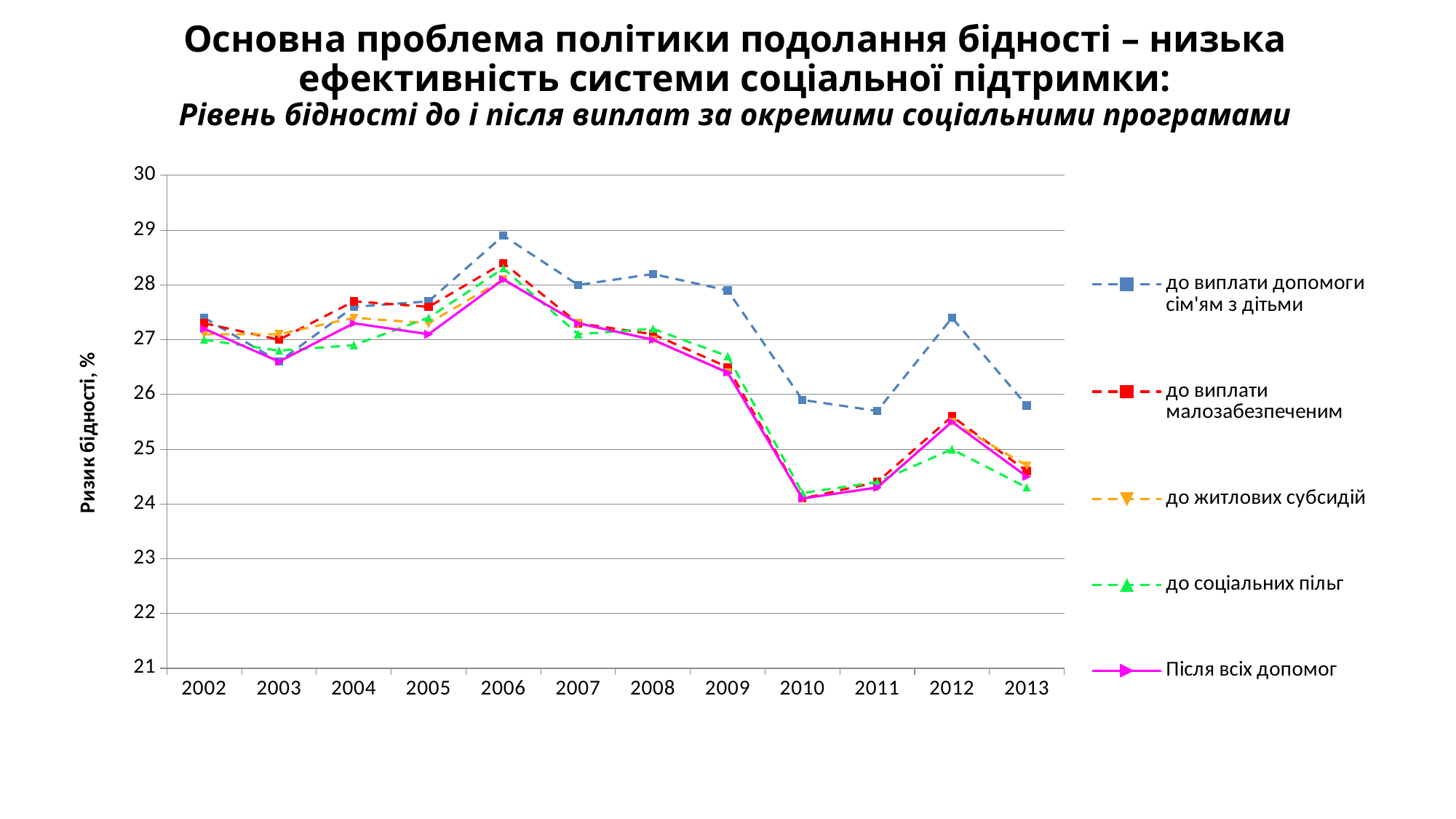
Does the series 'до виплати допомоги сім'ям з дітьми' rise or fall from 2009 to 2010? fall What is the label of the y axis? Ризик бідності, % Which series is drawn as a solid magenta line? Після всіх допомог In 2012, which series has the larger value: 'до виплати допомоги сім'ям з дітьми' or 'Після всіх допомог'? до виплати допомоги сім'ям з дітьми Is the value for 'до виплати допомоги сім'ям з дітьми' in 2012 greater or less than 27? greater Is the value for 'до виплати допомоги сім'ям з дітьми' in 2006 greater or less than 28? greater How many series does the legend list? 5 In which year does the series 'Після всіх допомог' reach its highest value? 2006 How many years are shown on the x axis? 12 In which year does the series 'до виплати допомоги сім'ям з дітьми' reach its highest value? 2006 Is the value for 'Після всіх допомог' in 2010 greater or less than 25? less What kind of chart is shown on the slide? line chart